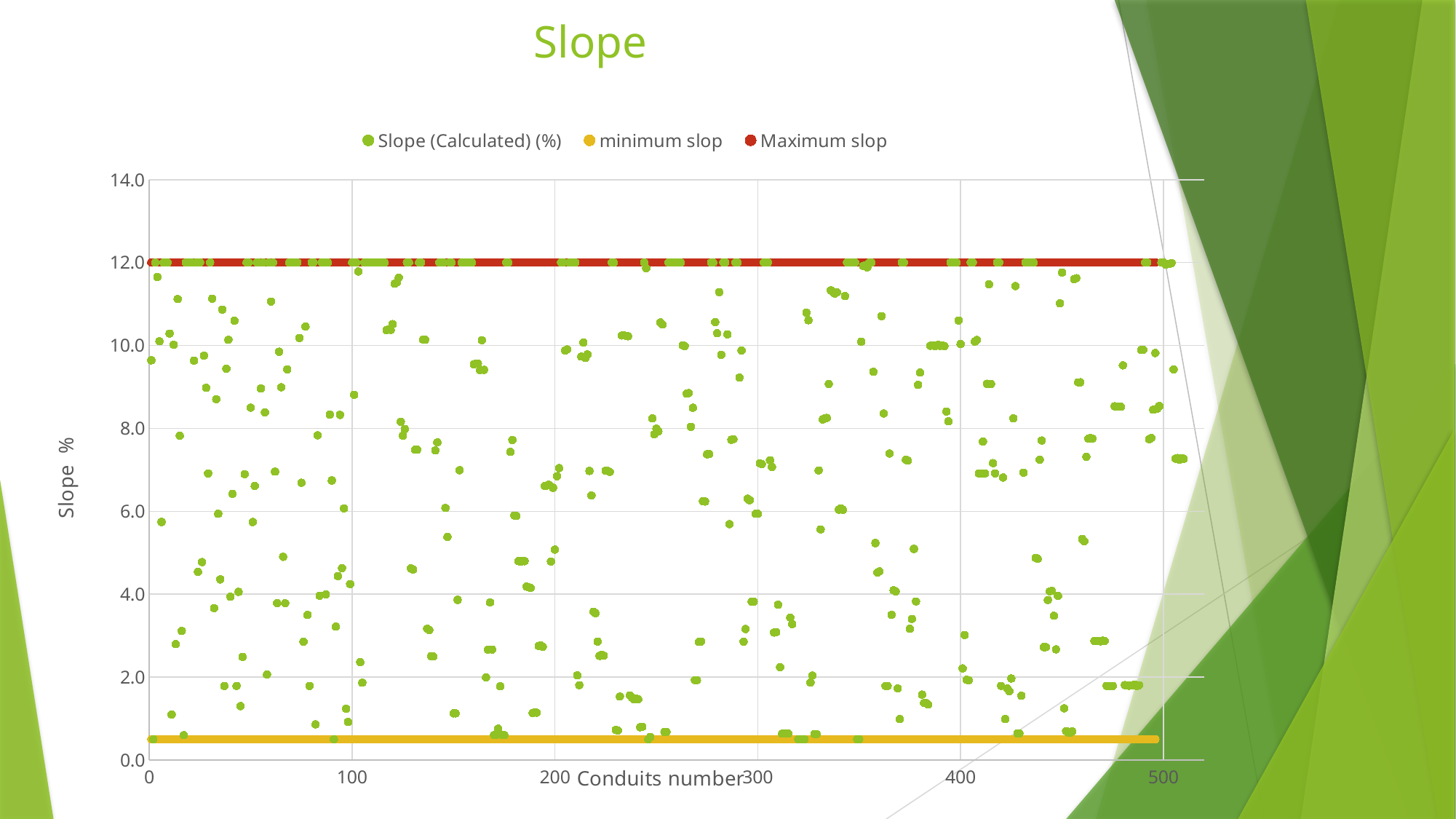
Which series has the larger value, Maximum slop or minimum slop? Maximum slop What colour are the Maximum slop markers in the legend? red Is the value of the minimum slop series greater or less than 4.0? less Which series is plotted at the highest level on the chart? Maximum slop Is the value of the Maximum slop series greater or less than 10.0? greater What value does the Maximum slop series sit at on the y axis? 12.0 What kind of chart is shown on the slide? scatter chart Is the value of the minimum slop series greater or less than 2.0? less How many series does the legend list? 3 What is the title of the chart? Slope Which series is plotted at the lowest level on the chart? minimum slop